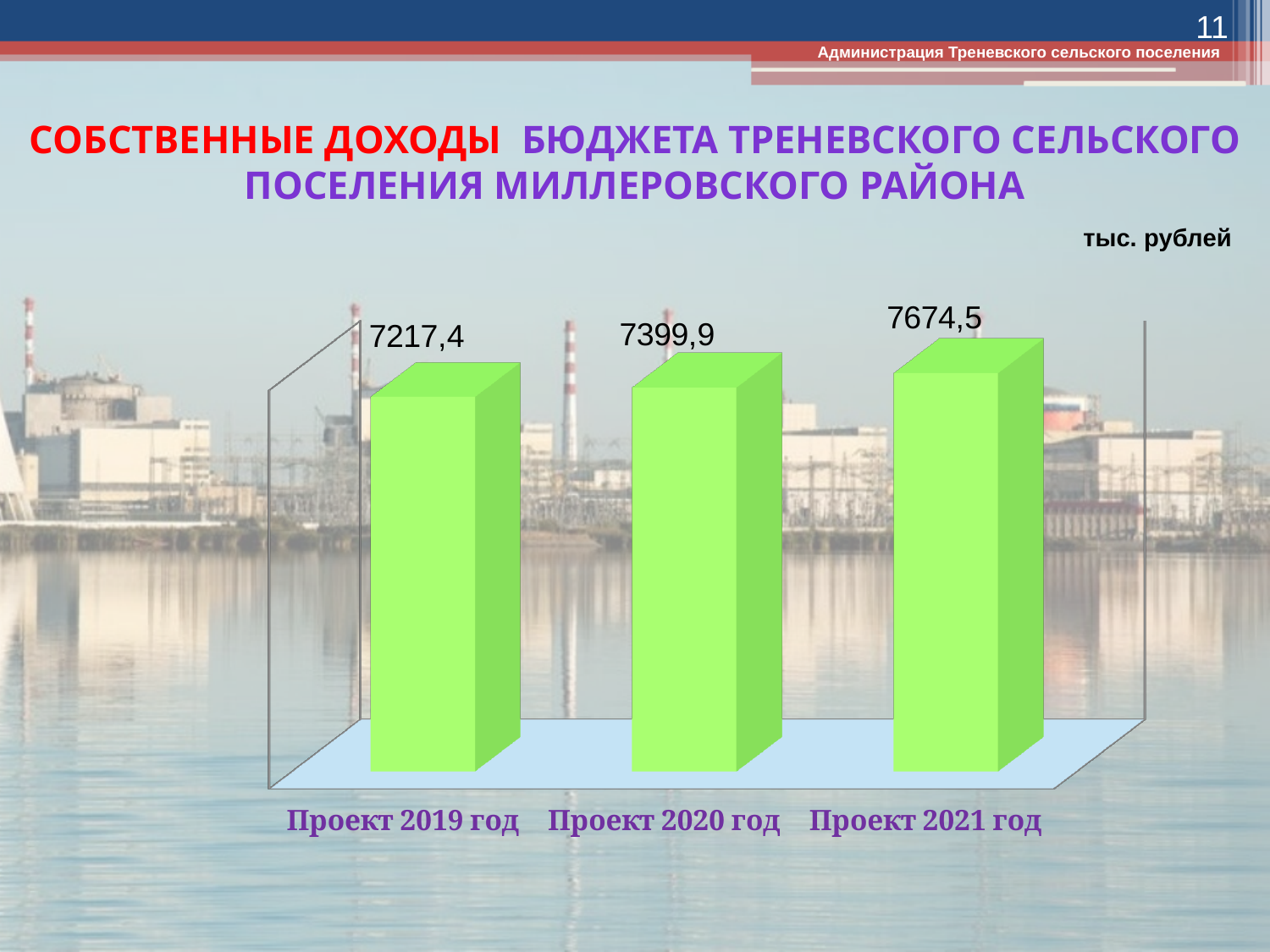
What is the value for Проект 2019 год? 7217,4 What is the difference between the values for Проект 2021 год and Проект 2020 год? 274,6 What is the value for Проект 2021 год? 7674,5 What is the difference between the values for Проект 2020 год and Проект 2019 год? 182,5 How many categories are shown in the chart? 3 Which category has the lowest value? Проект 2019 год What is the difference between the values for Проект 2021 год and Проект 2019 год? 457,1 Which category has the highest value? Проект 2021 год Do the values rise or fall from Проект 2019 год to Проект 2021 год? rise Which is larger, the value for Проект 2019 год or the value for Проект 2021 год? Проект 2021 год What kind of chart is shown on the slide? bar chart What is the value for Проект 2020 год? 7399,9